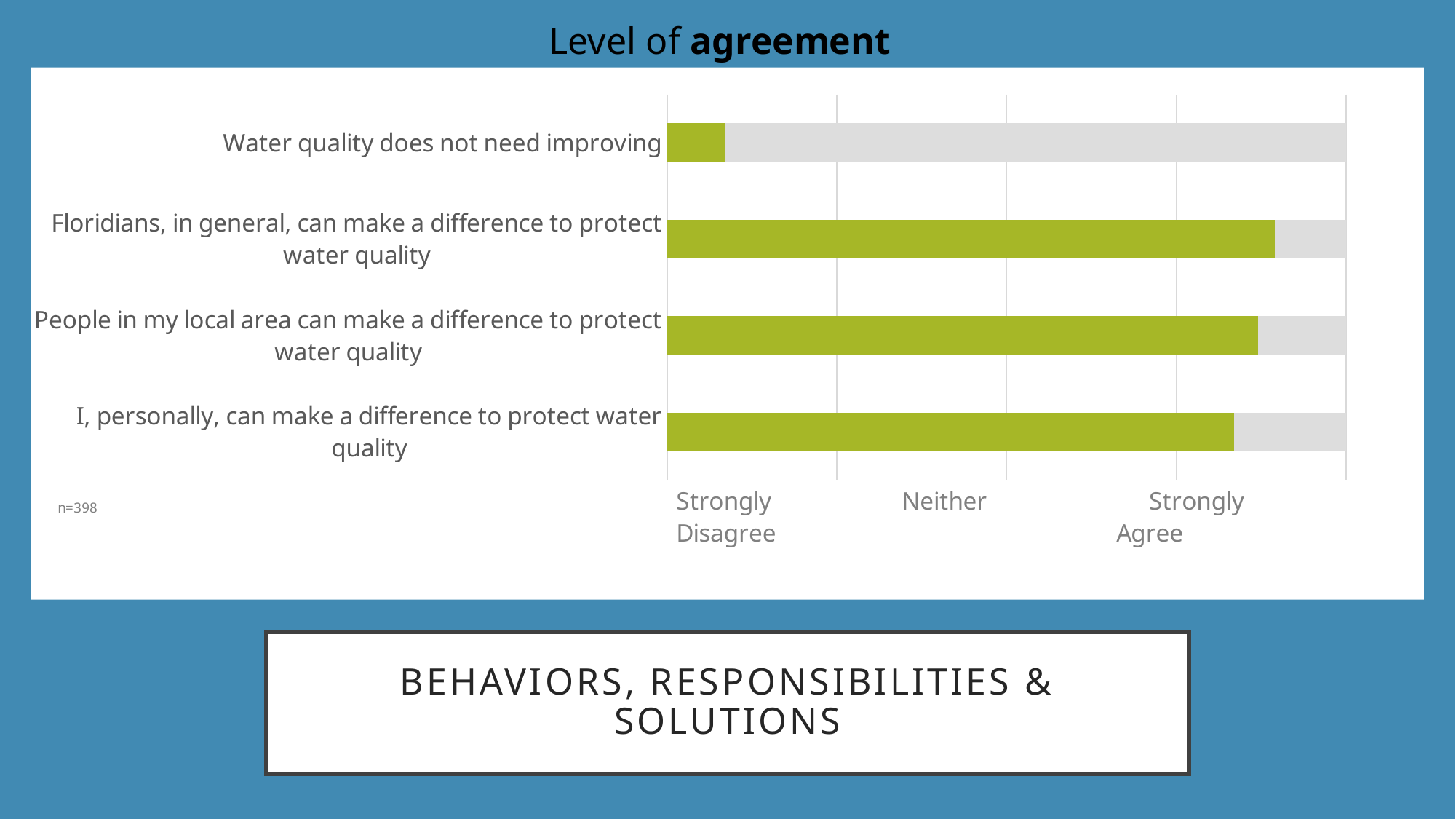
How many statements (categories) are plotted in the chart? 4 Does the bar for 'I, personally, can make a difference to protect water quality' extend past the 'Neither' line toward 'Strongly Agree'? Yes Which statement has the highest level of agreement in the chart? Floridians, in general, can make a difference to protect water quality What is the title of the chart? Level of agreement Does the bar for 'Water quality does not need improving' extend past the 'Neither' line toward 'Strongly Agree'? No Which has a higher level of agreement: 'People in my local area can make a difference to protect water quality' or 'I, personally, can make a difference to protect water quality'? People in my local area can make a difference to protect water quality Which statement has the lowest level of agreement in the chart? Water quality does not need improving What kind of chart is shown on the slide? Bar chart Which has a higher level of agreement: 'Water quality does not need improving' or 'I, personally, can make a difference to protect water quality'? I, personally, can make a difference to protect water quality What sample size (n) is noted on the chart? n=398 Which has a higher level of agreement: 'Floridians, in general, can make a difference to protect water quality' or 'I, personally, can make a difference to protect water quality'? Floridians, in general, can make a difference to protect water quality